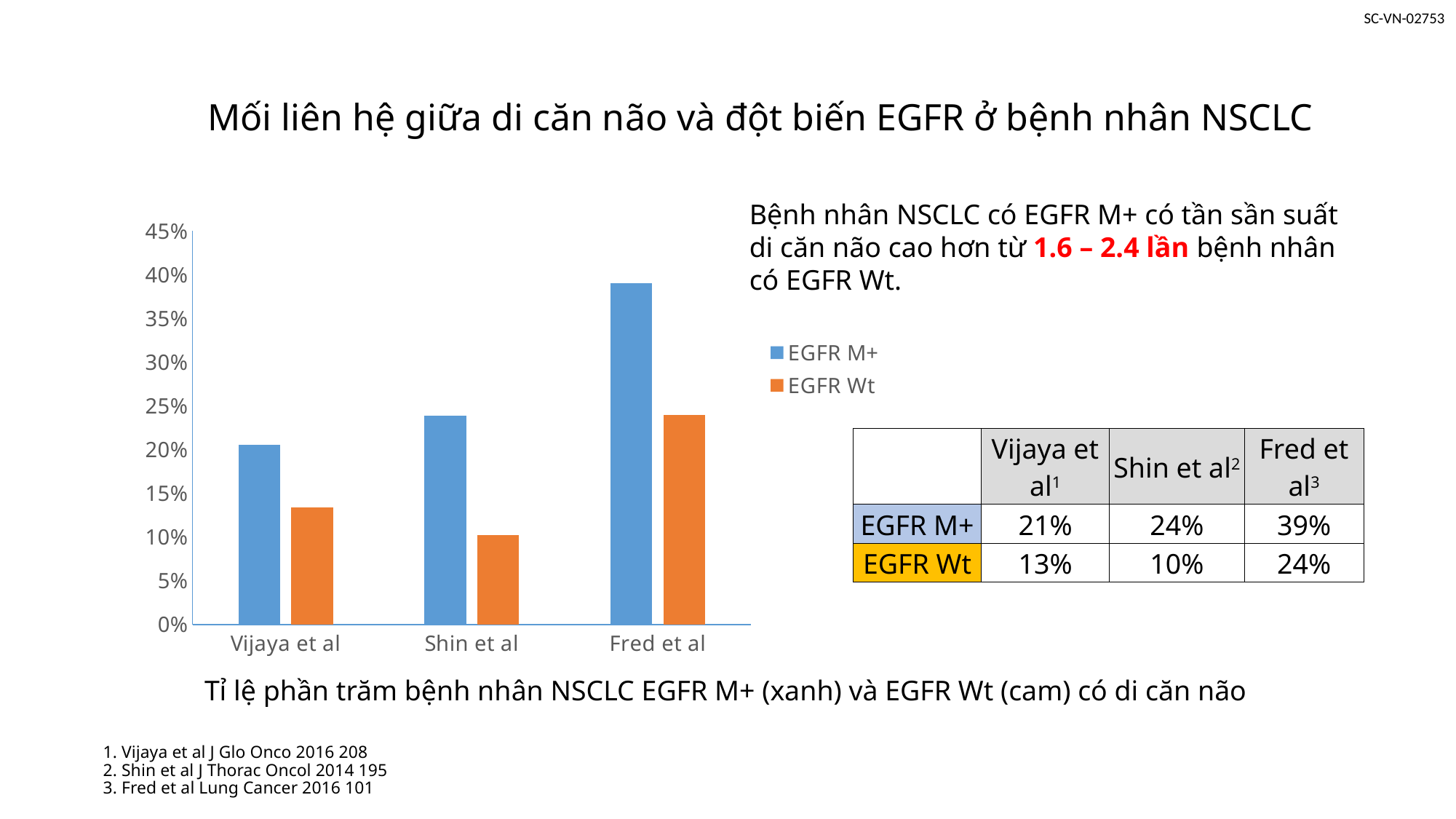
How many series does the chart legend list? 2 Which study has the highest EGFR M+ value? Fred et al What is the EGFR M+ value for Fred et al? 39% Which study has the lowest EGFR Wt value? Shin et al What is the EGFR Wt value for Shin et al? 10% What type of chart is shown on the slide? bar chart What is the difference between the EGFR M+ and EGFR Wt values for Fred et al? 15% What is the EGFR M+ value for Vijaya et al? 21% Which colour represents the EGFR Wt series in the chart? orange Is the EGFR M+ value for Fred et al greater or less than 35%? greater How many study categories are shown on the x axis of the chart? 3 Which is larger for Shin et al, the EGFR M+ value or the EGFR Wt value? EGFR M+